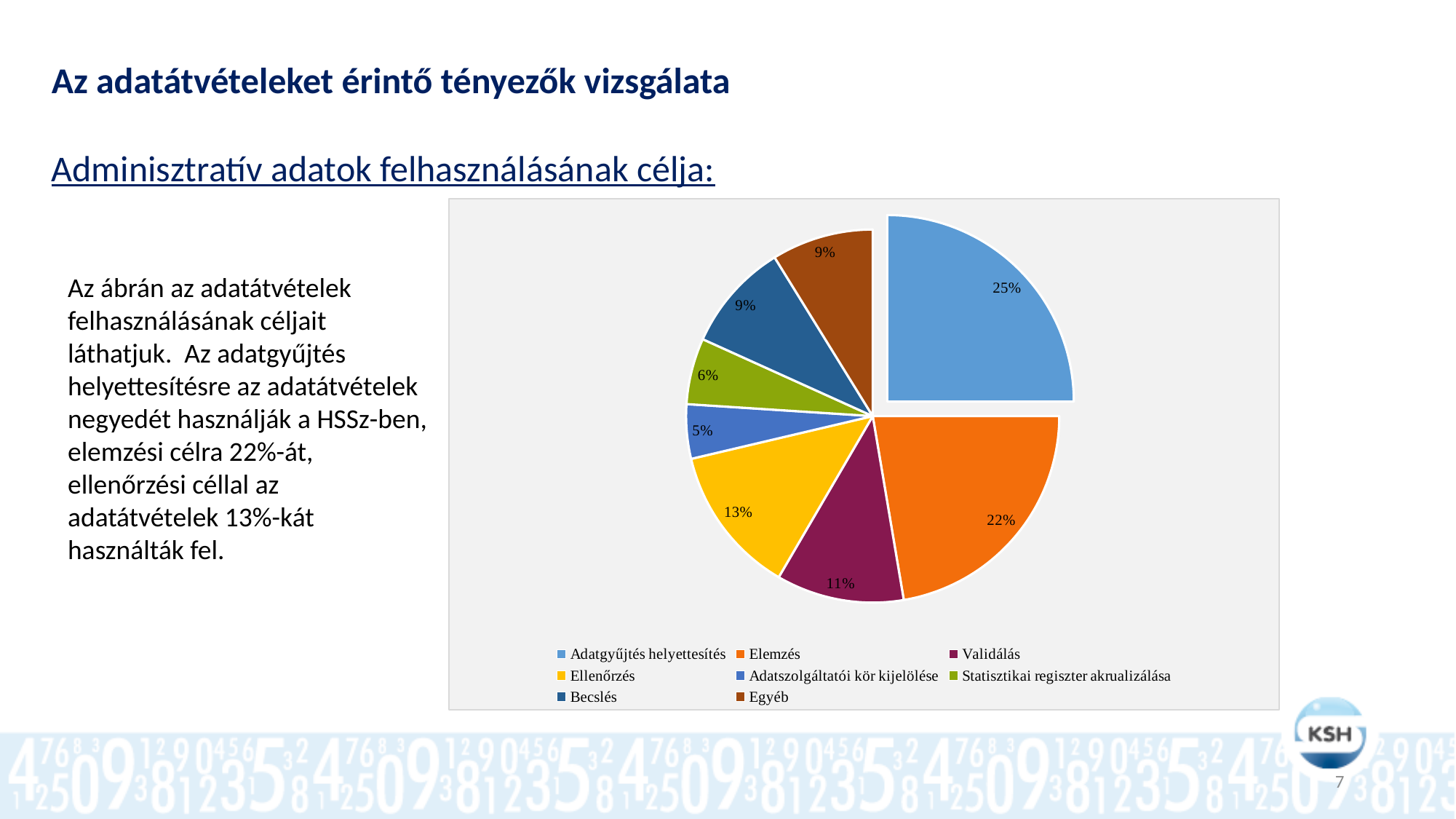
What is the difference in percentage points between Adatgyűjtés helyettesítés and Elemzés? 3 percentage points Which is larger, the share for Ellenőrzés or the share for Validálás? Ellenőrzés What kind of chart is shown on the slide? pie chart What share of the pie does Elemzés have? 22% What share of the pie does Ellenőrzés have? 13% Which category has the smallest slice of the pie? Adatszolgáltatói kör kijelölése What share of the pie does Adatszolgáltatói kör kijelölése have? 5% How many categories does the legend of the pie chart list? 8 Which category has the largest slice of the pie? Adatgyűjtés helyettesítés